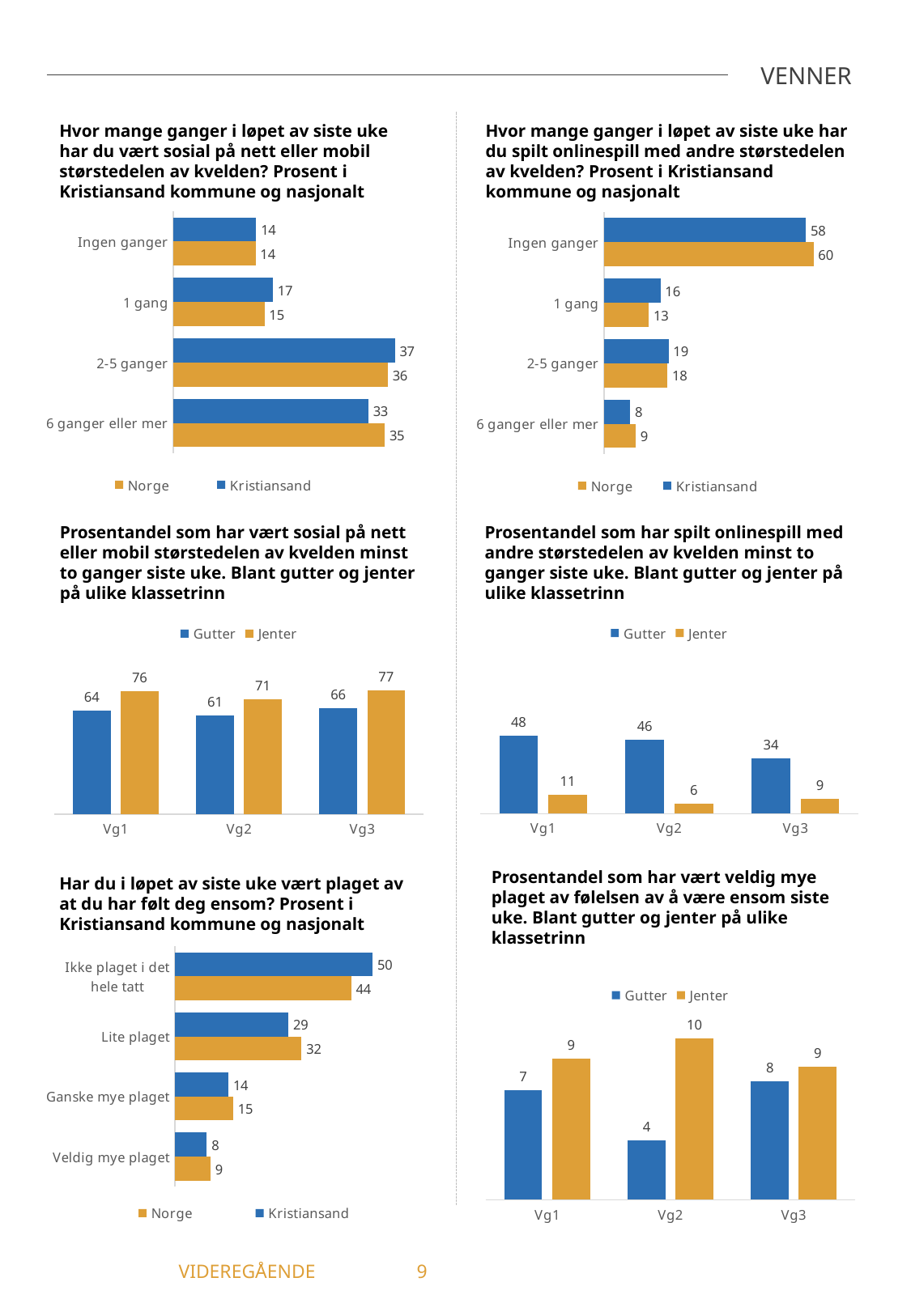
In the middle-left chart (sosial på nett minst to ganger, gutter og jenter), what is the difference between Jenter and Gutter for Vg1? 12 In the middle-right chart (onlinespill minst to ganger, gutter og jenter), what is the Gutter value for Vg2? 46 In the bottom-left chart (plaget av å ha følt deg ensom), how many categories are shown? 4 In the middle-right chart (onlinespill minst to ganger, gutter og jenter), do the Gutter values rise or fall from Vg1 to Vg3? fall In the top-right chart (spilt onlinespill), what is the Norge value for 'Ingen ganger'? 60 In the bottom-left chart (plaget av å ha følt deg ensom), which is larger for 'Lite plaget': Norge or Kristiansand? Norge In the top-left chart (sosial på nett eller mobil), what is the Kristiansand value for '2-5 ganger'? 37 In the top-right chart (spilt onlinespill), which category has the lowest Kristiansand value? 6 ganger eller mer In the bottom-right chart (veldig mye plaget av ensomhet, gutter og jenter), which class level has the lowest Gutter value? Vg2 In the bottom-right chart (veldig mye plaget av ensomhet, gutter og jenter), what is the Jenter value for Vg2? 10 In the middle-left chart (sosial på nett minst to ganger, gutter og jenter), which class level has the highest Jenter value? Vg3 What type of chart is the top-left chart (sosial på nett eller mobil)? bar chart